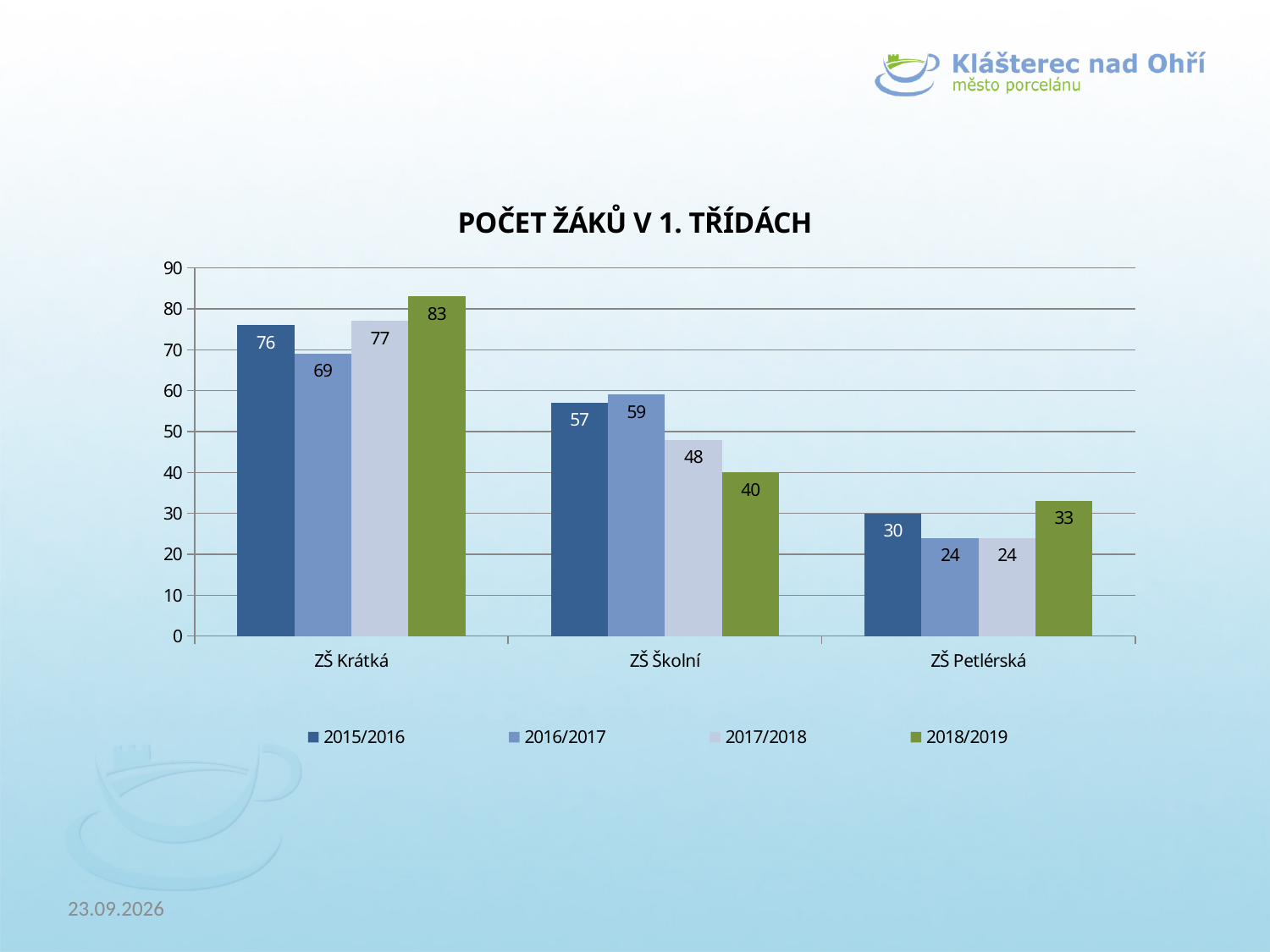
What is the title of the chart? POČET ŽÁKŮ V 1. TŘÍDÁCH How many schools (categories) are shown on the x axis? 3 What is the value for ZŠ Školní in the 2017/2018 series? 48 Which is larger for ZŠ Školní: the 2015/2016 value or the 2016/2017 value? 2016/2017 What is the difference between the 2018/2019 and 2015/2016 values for ZŠ Krátká? 7 What kind of chart is shown on the slide? Bar chart How many series does the legend list? 4 What is the value for ZŠ Krátká in the 2018/2019 series? 83 What is the value for ZŠ Petlérská in the 2015/2016 series? 30 Which school has the highest value in the 2016/2017 series? ZŠ Krátká Which school has the lowest value in the 2018/2019 series? ZŠ Petlérská What is the difference between the 2015/2016 and 2018/2019 values for ZŠ Školní? 17